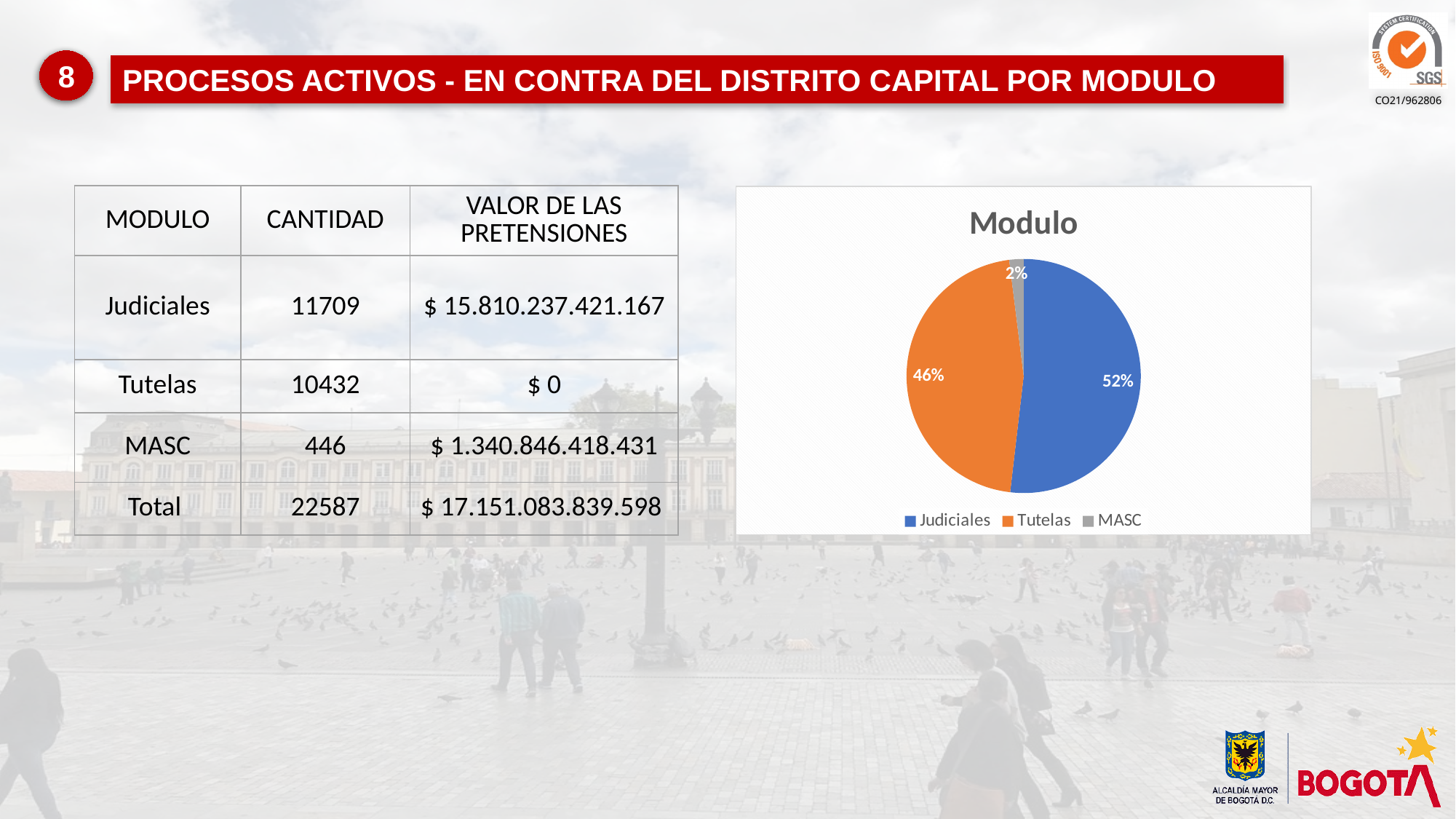
Which category has the smallest slice of the pie? MASC What share of the pie does MASC represent? 2% How many categories does the pie chart show? 3 What is the difference in percentage points between the Judiciales and Tutelas slices? 6 Which slice is larger, Tutelas or MASC? Tutelas Which category has the largest slice of the pie? Judiciales What colour is the Tutelas slice in the pie chart? orange How many entries does the legend list? 3 What kind of chart is shown on the slide? pie chart What share of the pie does Tutelas represent? 46% What share of the pie does Judiciales represent? 52% What is the title of the chart? Modulo